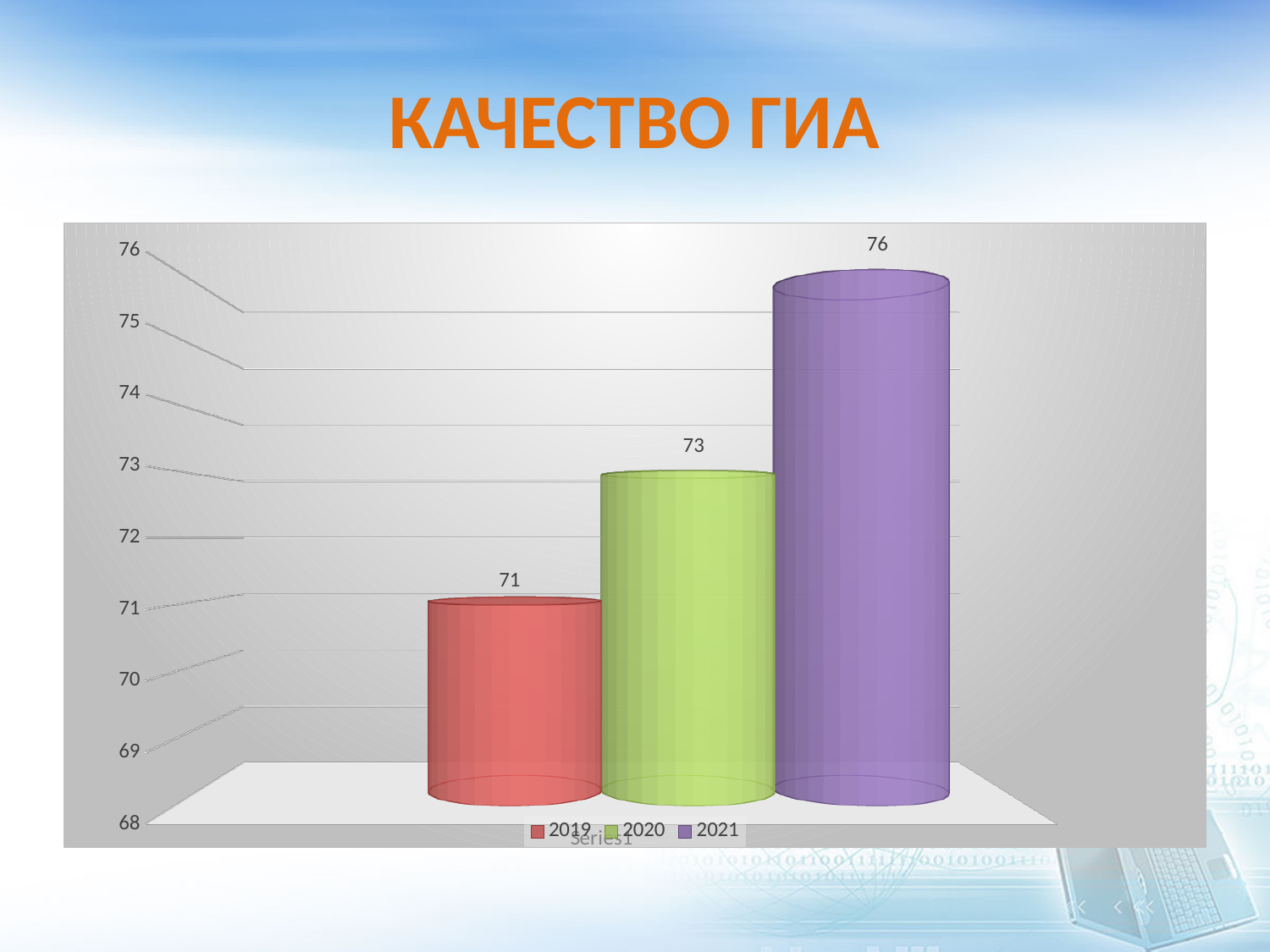
What kind of chart is shown on the slide? bar chart What is the value for 2019? 71 How many entries does the legend list? 3 What is the title of the slide? КАЧЕСТВО ГИА What is the difference between the values for 2020 and 2019? 2 Which year has the lowest value? 2019 What is the difference between the values for 2021 and 2019? 5 Which year has the highest value? 2021 Which is larger, the value for 2020 or the value for 2021? 2021 What is the value for 2020? 73 How many bars are shown in the chart? 3 What is the value for 2021? 76